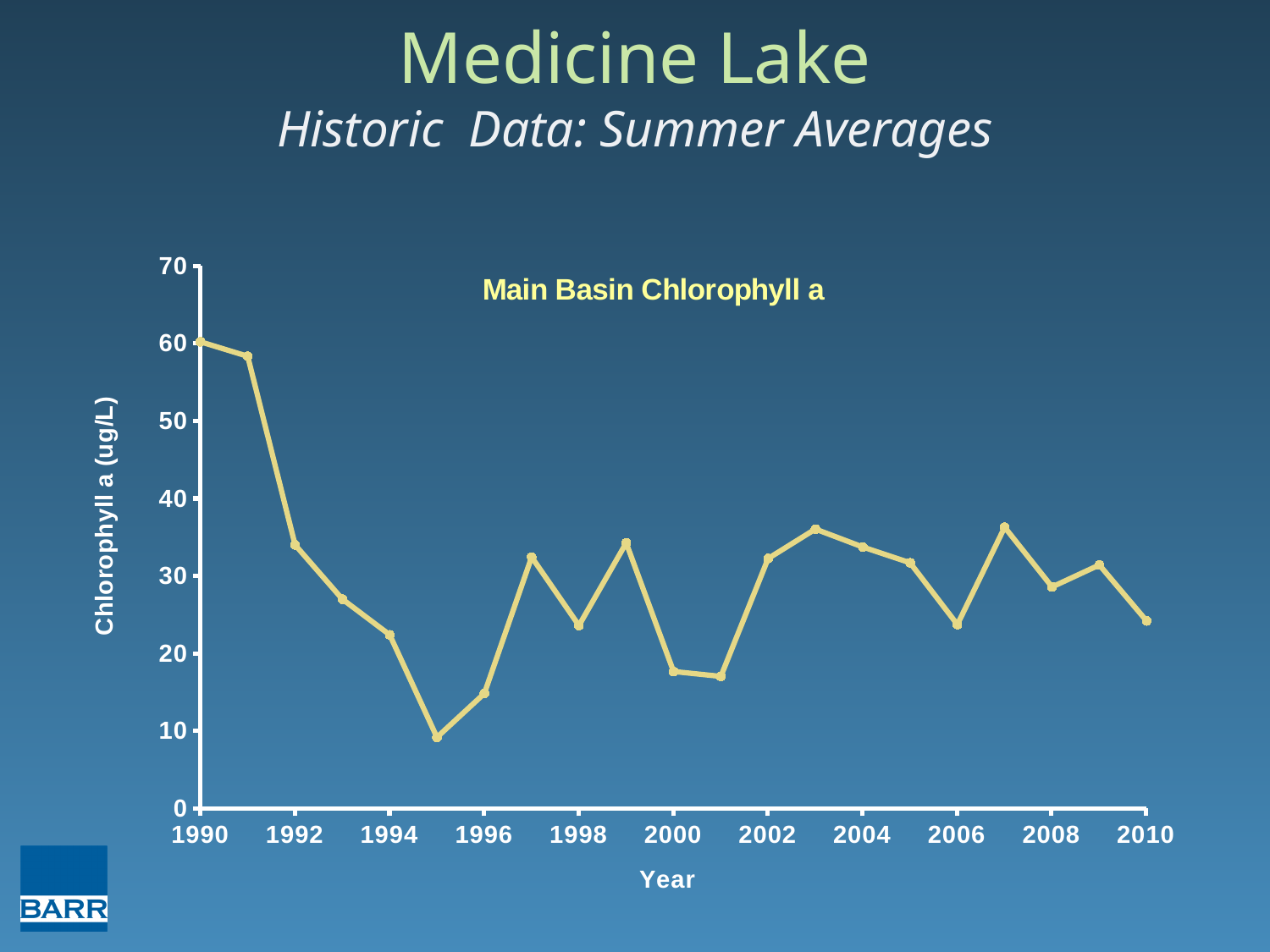
What is the label of the vertical axis? Chlorophyll a (ug/L) What kind of chart is shown on the slide? line chart Which year has the lowest chlorophyll a value? 1995 Is the value for 2000 greater or less than 20? less Is the value for 1991 greater or less than 50? greater What is the title of the chart? Main Basin Chlorophyll a Do the values rise or fall from 1990 to 1995? fall Is the value for 2003 greater or less than 30? greater Which year has the larger chlorophyll a value, 1990 or 2010? 1990 Which year has the highest chlorophyll a value? 1990